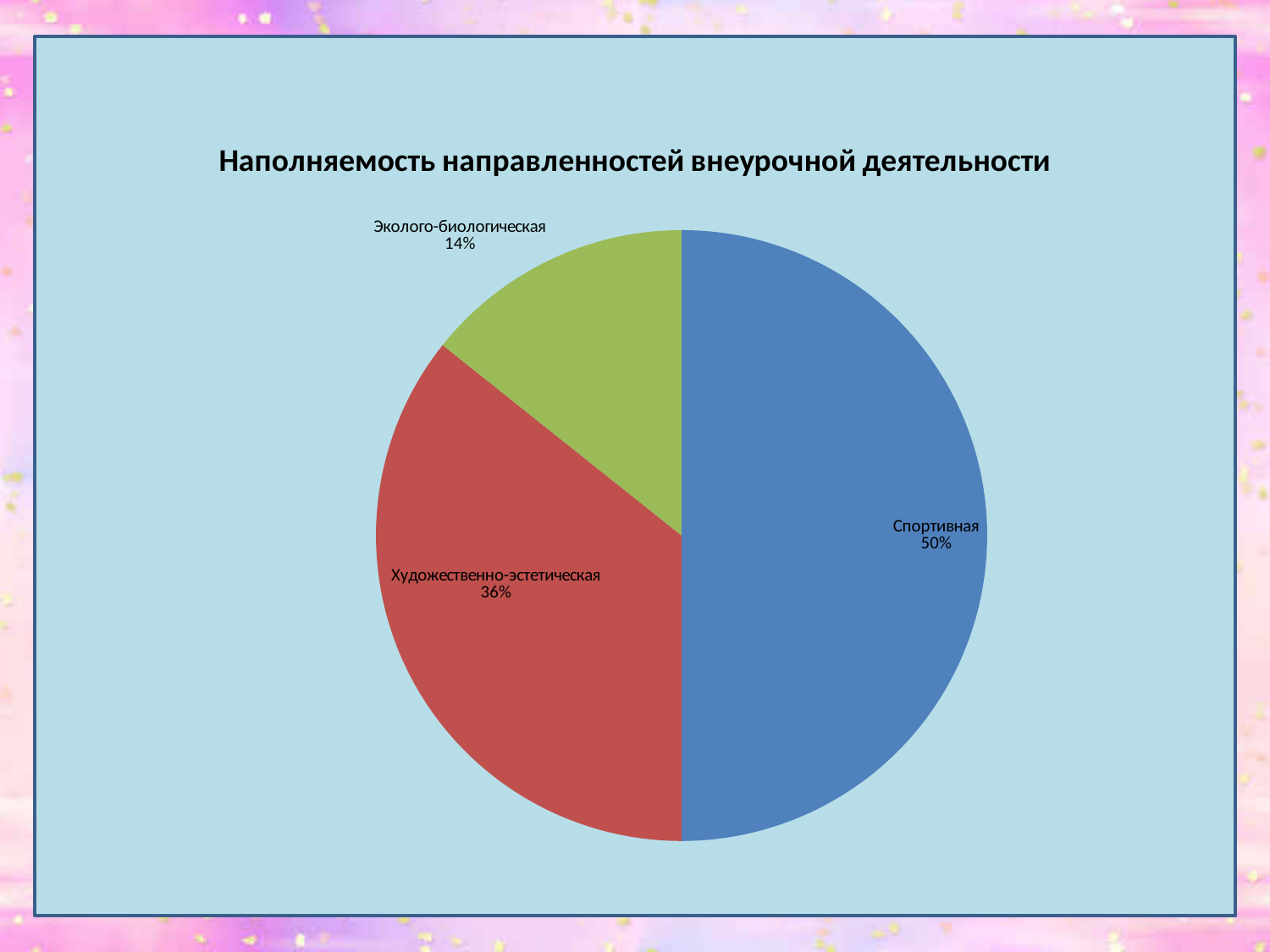
What colour is the Спортивная slice? blue What is the difference between the shares of Спортивная and Художественно-эстетическая? 14% Which category has the smallest share of the pie? Эколого-биологическая What share of the pie does Эколого-биологическая take? 14% What is the title of the chart? Наполняемость направленностей внеурочной деятельности How many slices does the pie chart have? 3 What share of the pie does Художественно-эстетическая take? 36% What kind of chart is shown on the slide? pie chart What share of the pie does Спортивная take? 50% What is the difference between the shares of Художественно-эстетическая and Эколого-биологическая? 22% Which is larger, the share of Художественно-эстетическая or Эколого-биологическая? Художественно-эстетическая Which category has the largest share of the pie? Спортивная